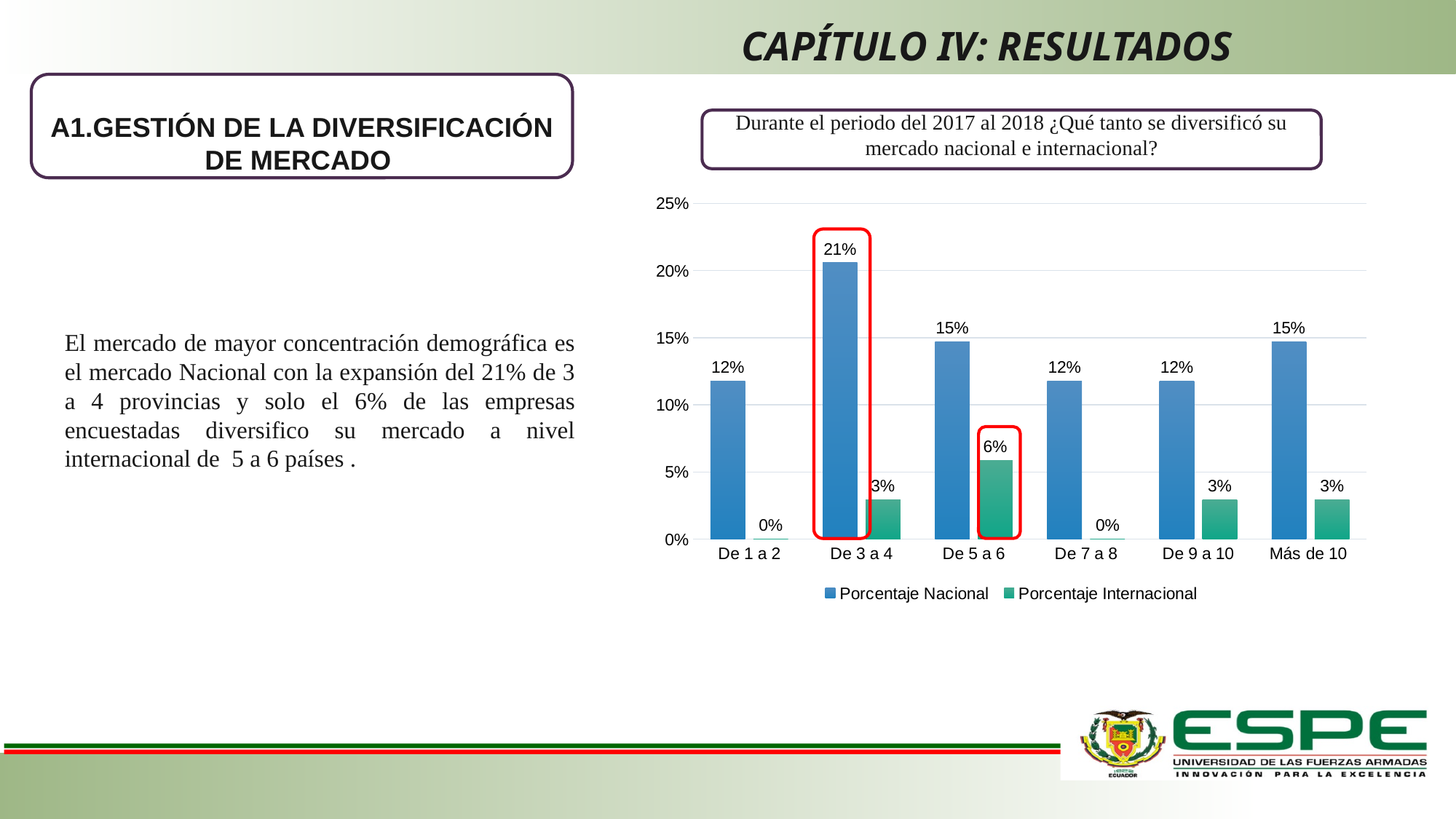
Which category has the highest Porcentaje Internacional value? De 5 a 6 What is the Porcentaje Internacional value for the category De 5 a 6? 6% What is the Porcentaje Nacional value for Más de 10? 15% What is the Porcentaje Nacional value for the category De 3 a 4? 21% How many series does the chart legend list? 2 Which category has the highest Porcentaje Nacional value? De 3 a 4 What is the difference between the Porcentaje Nacional and Porcentaje Internacional values for De 3 a 4? 18% What is the difference between the Porcentaje Nacional and Porcentaje Internacional values for De 5 a 6? 9% How many categories are shown on the x axis of the chart? 6 What is the Porcentaje Internacional value for De 7 a 8? 0% Which is larger, the Porcentaje Nacional value for De 5 a 6 or for De 9 a 10? De 5 a 6 What kind of chart is shown on the slide? Bar chart